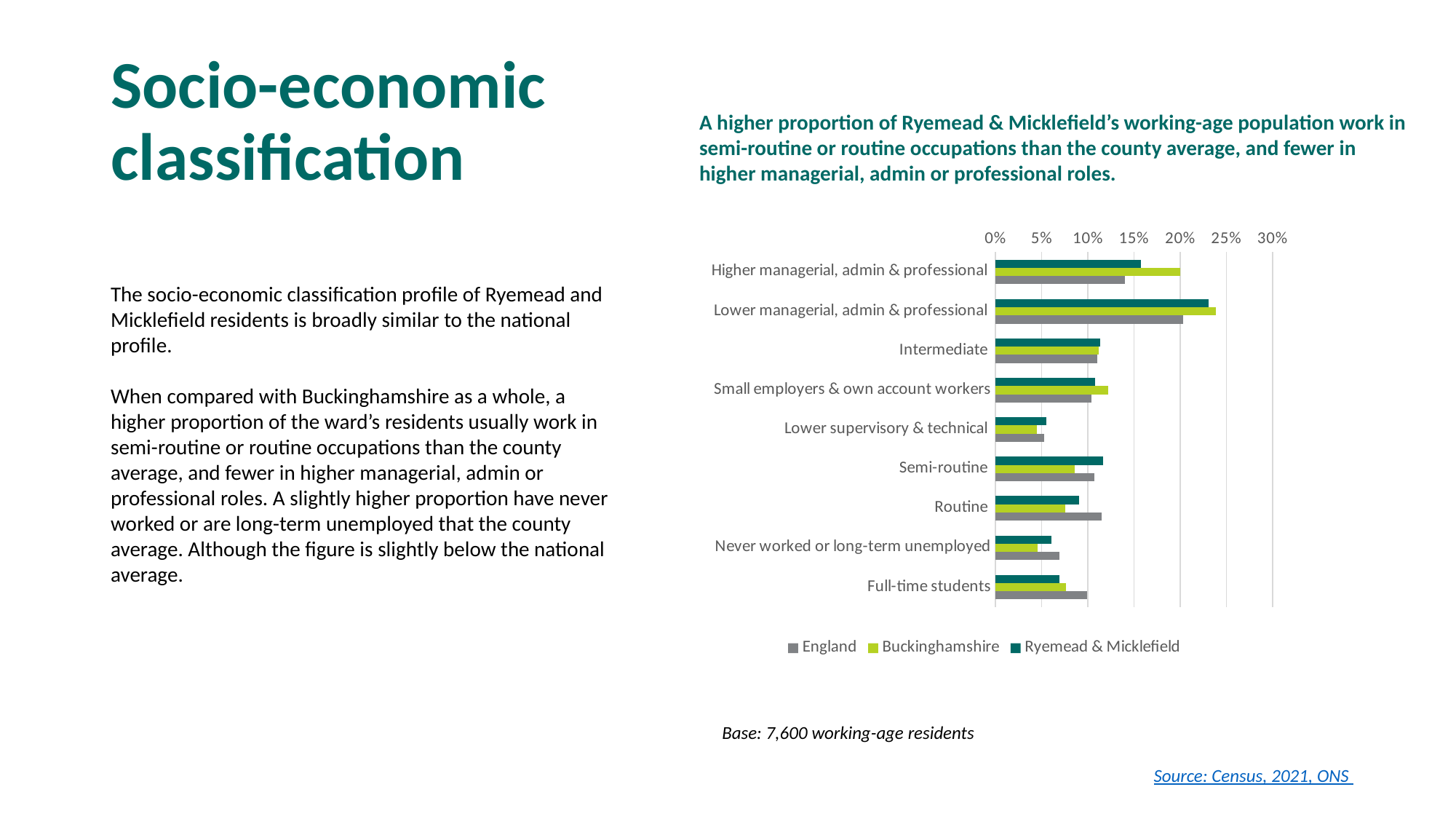
For Routine, which is larger: England or Ryemead & Micklefield? England For Higher managerial, admin & professional, which is larger: Buckinghamshire or Ryemead & Micklefield? Buckinghamshire Which category has the lowest value for England? Lower supervisory & technical Is the Buckinghamshire value for Lower managerial, admin & professional greater or less than 20%? greater How many series does the chart legend list? 3 For Semi-routine, which is larger: Ryemead & Micklefield or Buckinghamshire? Ryemead & Micklefield How many socio-economic categories are plotted on the chart? 9 Is the Ryemead & Micklefield value for Never worked or long-term unemployed greater or less than 10%? less Which series is shown in grey in the chart legend? England Which category has the highest value for Buckinghamshire? Lower managerial, admin & professional Which category has the highest value for Ryemead & Micklefield? Lower managerial, admin & professional What kind of chart is shown on the slide? Bar chart